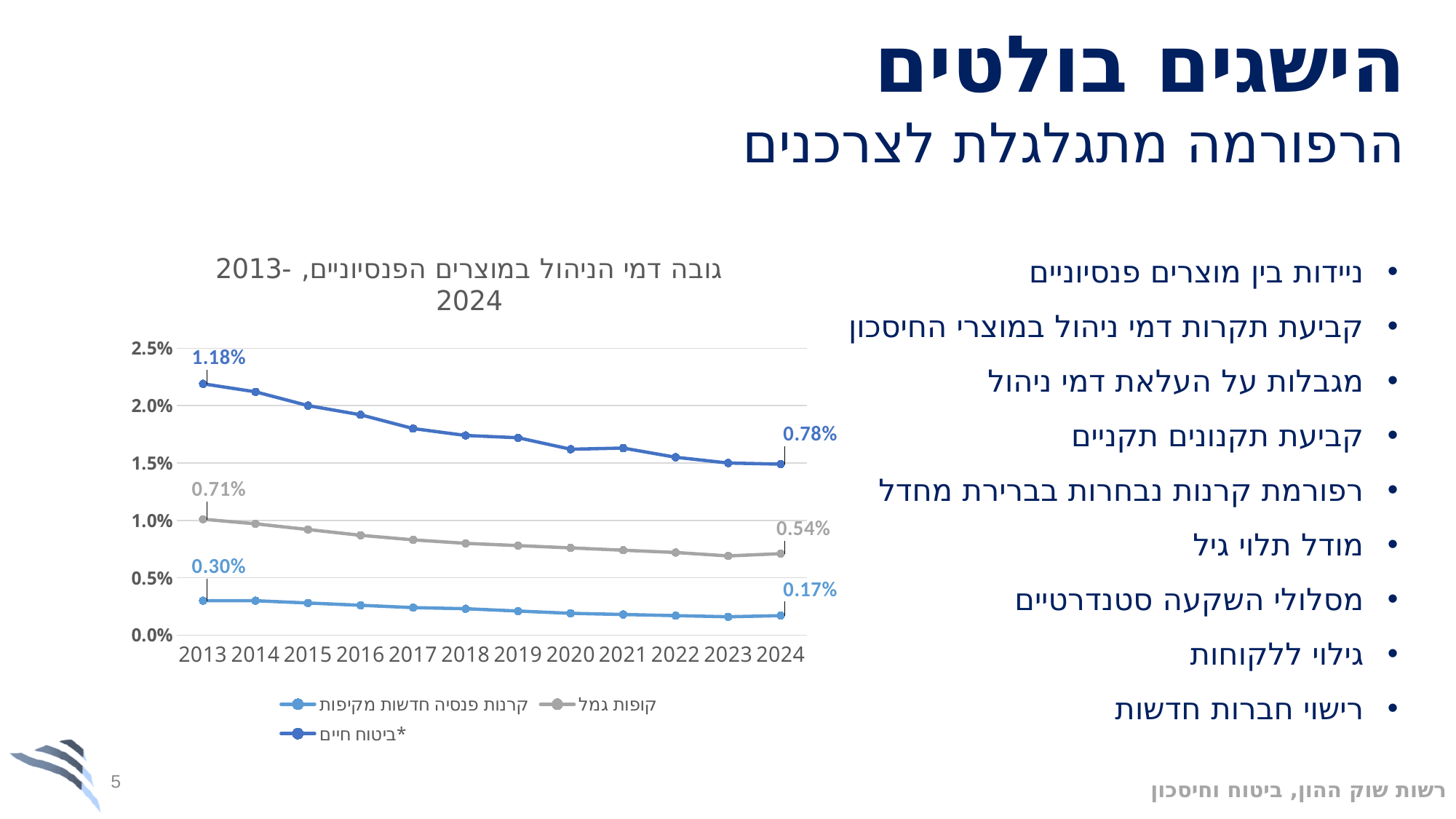
How many years are shown on the x axis? 12 Which series has the lowest values throughout the chart? קרנות פנסיה חדשות מקיפות How many series does the legend list? 3 By how much did the labelled value for ביטוח חיים* fall from 2013 to 2024? 0.40% What is the data label shown for קרנות פנסיה חדשות מקיפות in 2024? 0.17% What is the data label shown for ביטוח חיים* in 2024? 0.78% Which series has the highest values throughout the chart? ביטוח חיים* What is the data label shown for קופות גמל in 2024? 0.54% By how much did the labelled value for קרנות פנסיה חדשות מקיפות fall from 2013 to 2024? 0.13% What is the data label shown for קופות גמל in 2013? 0.71% Do the values for ביטוח חיים* rise or fall from 2013 to 2024? fall What is the data label shown for ביטוח חיים* in 2013? 1.18%